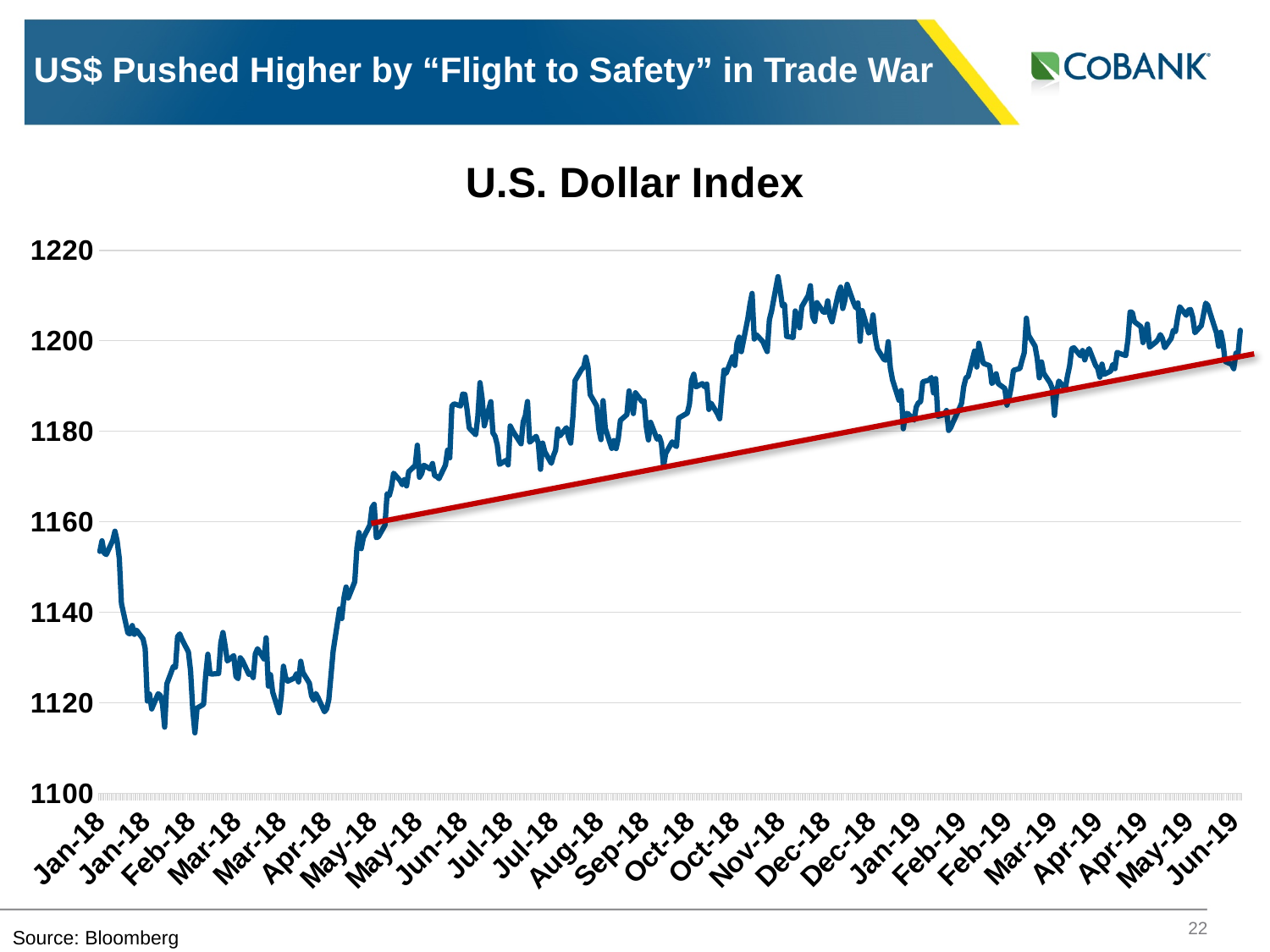
Overall, does the U.S. Dollar Index rise or fall from Jan-18 to Jun-19? Rise Does the red line drawn on the chart slope upward or downward? Upward Around which month does the U.S. Dollar Index reach its highest point on the chart? Nov-18 Is the value of the U.S. Dollar Index at the start of Jan-18 greater or less than 1140? greater What is the title of the chart? U.S. Dollar Index Is the peak value of the U.S. Dollar Index in Nov-18 greater or less than 1200? greater Is the value of the U.S. Dollar Index in Jul-18 greater or less than 1160? greater What kind of chart is shown on the slide? Line chart Which is higher, the U.S. Dollar Index in Nov-18 or in Feb-18? Nov-18 Around which month does the U.S. Dollar Index reach its lowest point on the chart? Feb-18